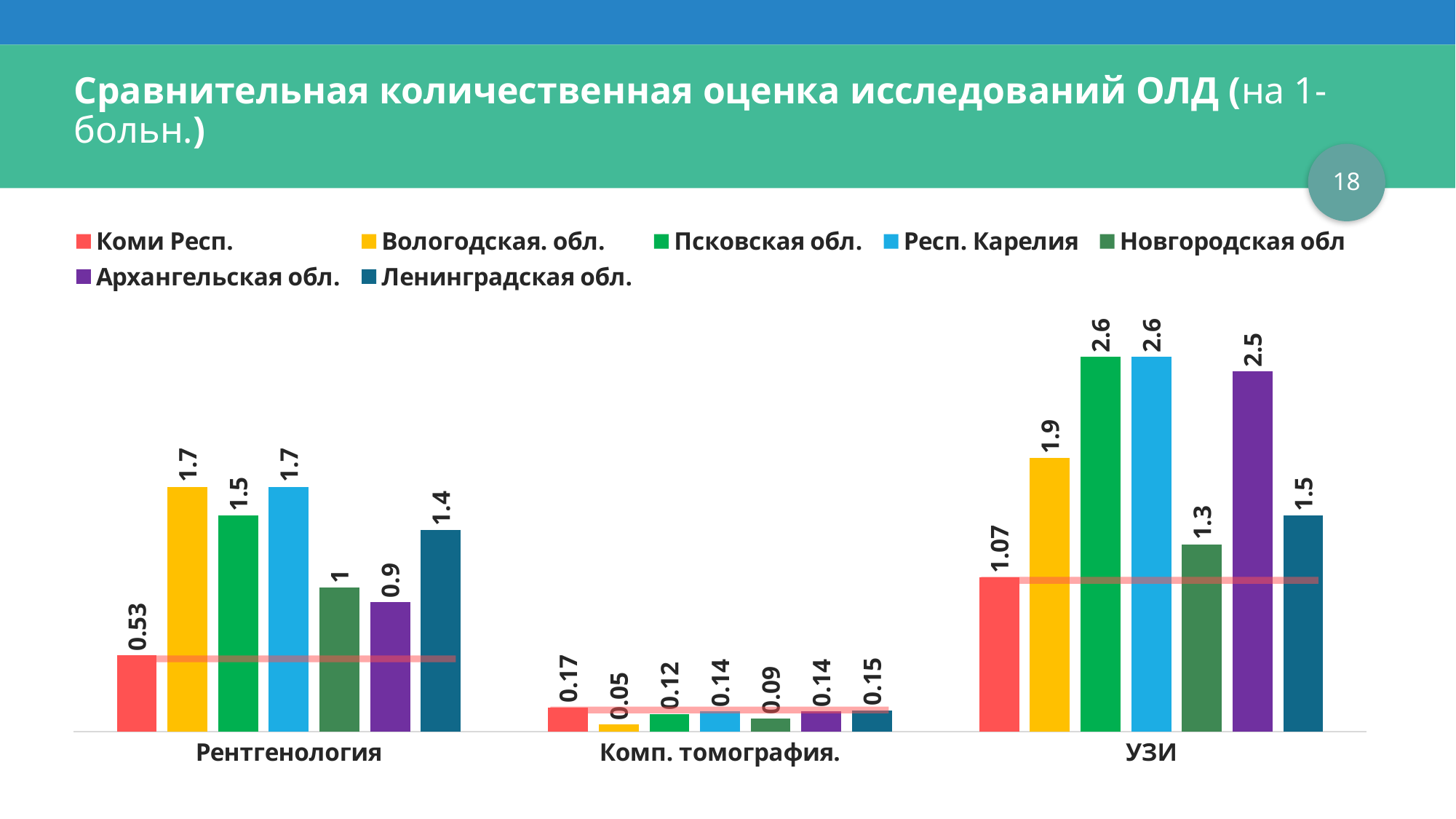
How many series does the legend list? 7 How many categories are shown on the x axis? 3 What kind of chart is shown on the slide? Bar chart Which region has the lowest value in the Комп. томография category? Вологодская. обл. What is the value for Новгородская обл in the Комп. томография category? 0.09 What is the difference between Вологодская. обл. and Коми Респ. in the УЗИ category? 0.83 Which region has the highest value in the Комп. томография category? Коми Респ. What is the value for Коми Респ. in the Рентгенология category? 0.53 Which region has the lowest value in the Рентгенология category? Коми Респ. What is the value for Ленинградская обл. in the УЗИ category? 1.5 Which region has the lowest value in the УЗИ category? Коми Респ. In the Рентгенология category, which is larger: Псковская обл. or Архангельская обл.? Псковская обл.